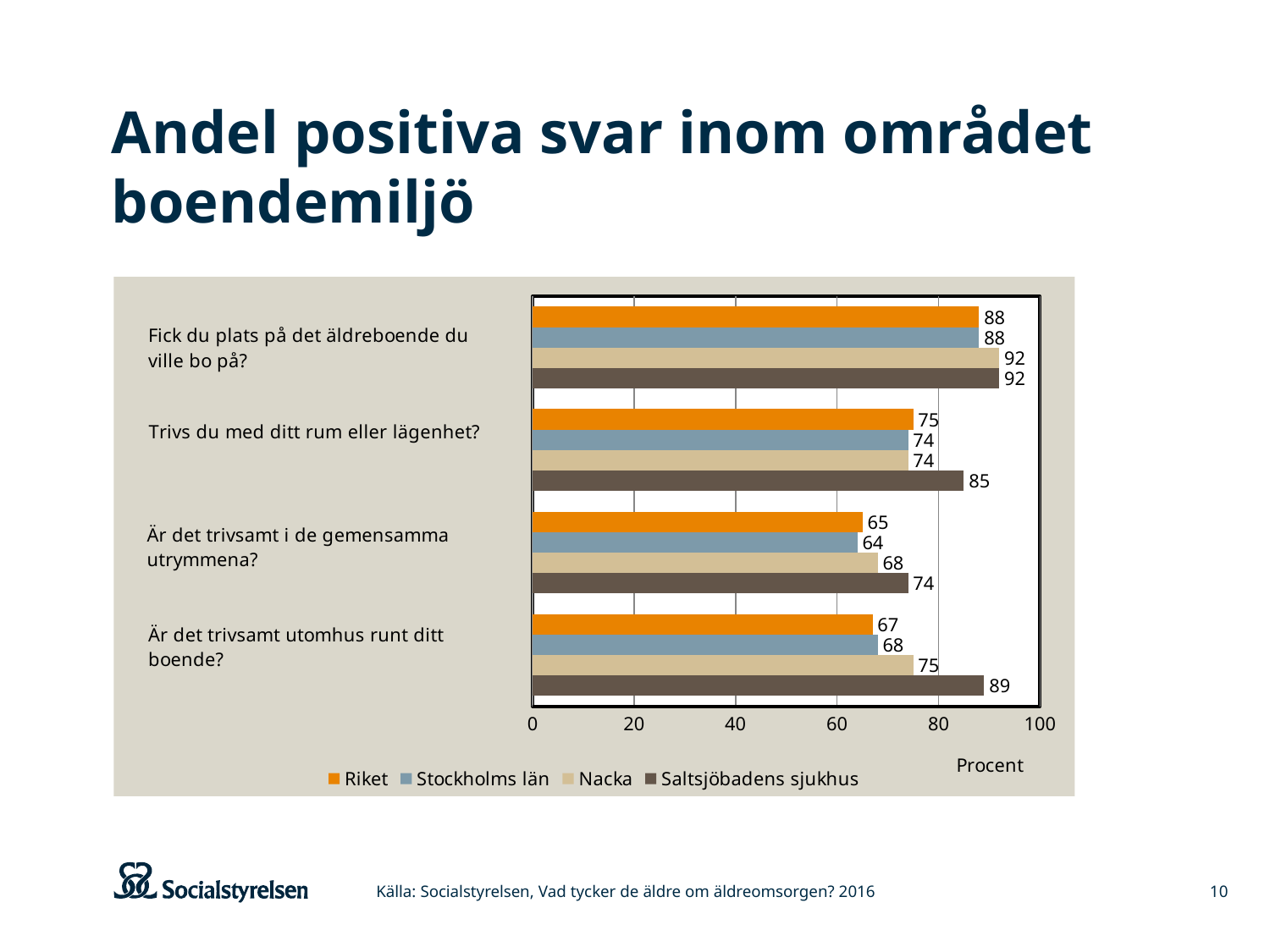
What is the value for Saltsjöbadens sjukhus on "Trivs du med ditt rum eller lägenhet?"? 85 What kind of chart is shown on the slide? Bar chart What is the value for Riket on "Är det trivsamt i de gemensamma utrymmena?"? 65 What is the value for Stockholms län on "Fick du plats på det äldreboende du ville bo på?"? 88 What is the value for Nacka on "Är det trivsamt utomhus runt ditt boende?"? 75 Which is larger on "Trivs du med ditt rum eller lägenhet?": Riket or Saltsjöbadens sjukhus? Saltsjöbadens sjukhus How many series does the legend list? 4 What is the label of the horizontal axis? Procent Which series has the lowest value on "Är det trivsamt i de gemensamma utrymmena?"? Stockholms län Which series has the highest value on "Är det trivsamt utomhus runt ditt boende?"? Saltsjöbadens sjukhus How many question categories are shown on the chart? 4 What is the difference between Saltsjöbadens sjukhus and Riket on "Är det trivsamt utomhus runt ditt boende?"? 22